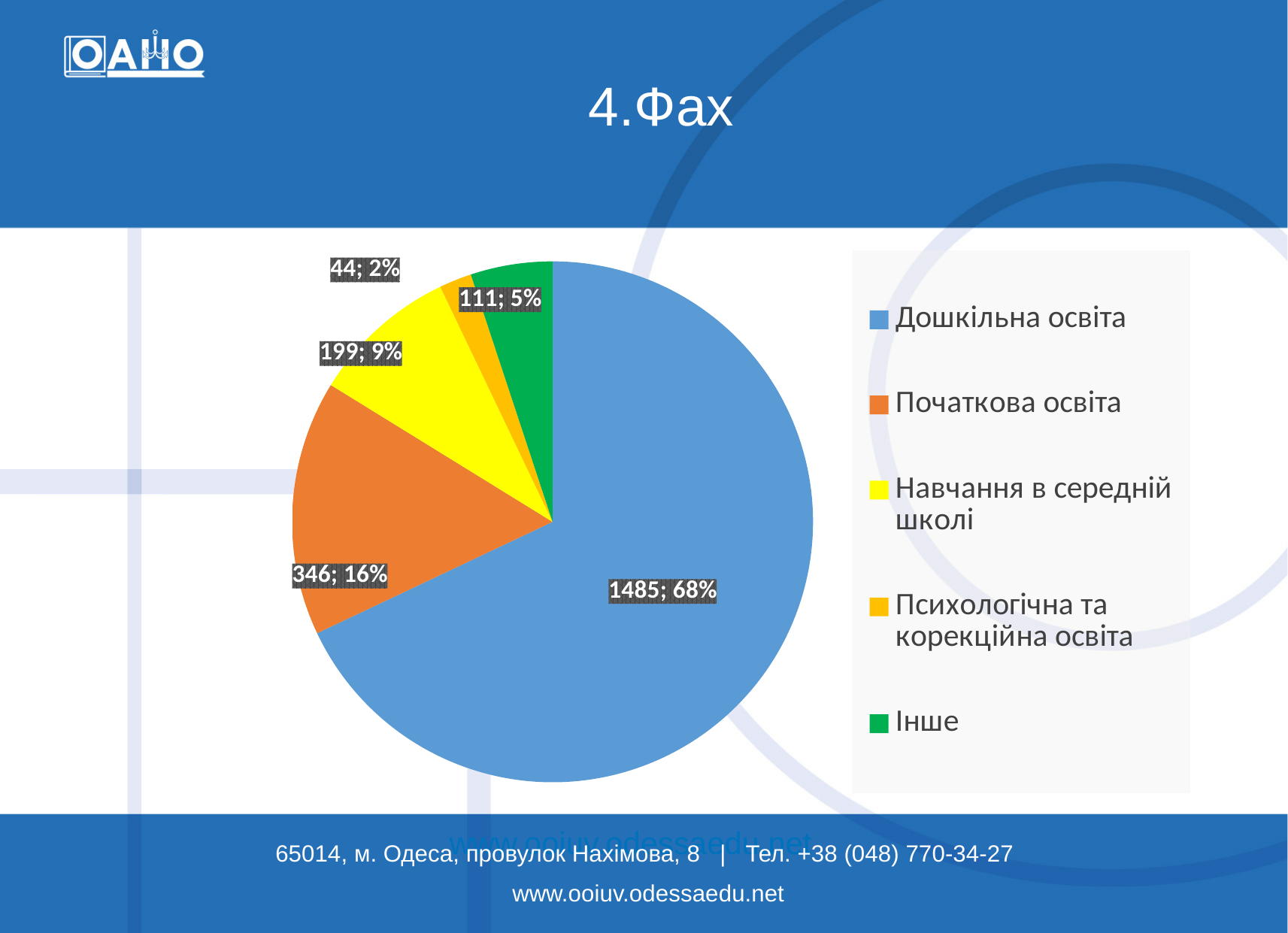
What share of the pie does Початкова освіта represent? 16% Which is larger, the value for Інше or the value for Психологічна та корекційна освіта? Інше What kind of chart is shown on the slide? pie chart What is the value for Психологічна та корекційна освіта? 44 What is the value for Початкова освіта? 346 What is the difference between the values for Дошкільна освіта and Початкова освіта? 1139 What is the value for Навчання в середній школі? 199 What is the value for Інше? 111 What is the value for Дошкільна освіта? 1485 Which category has the smallest slice of the pie? Психологічна та корекційна освіта How many categories does the pie chart have? 5 Which category has the largest slice of the pie? Дошкільна освіта